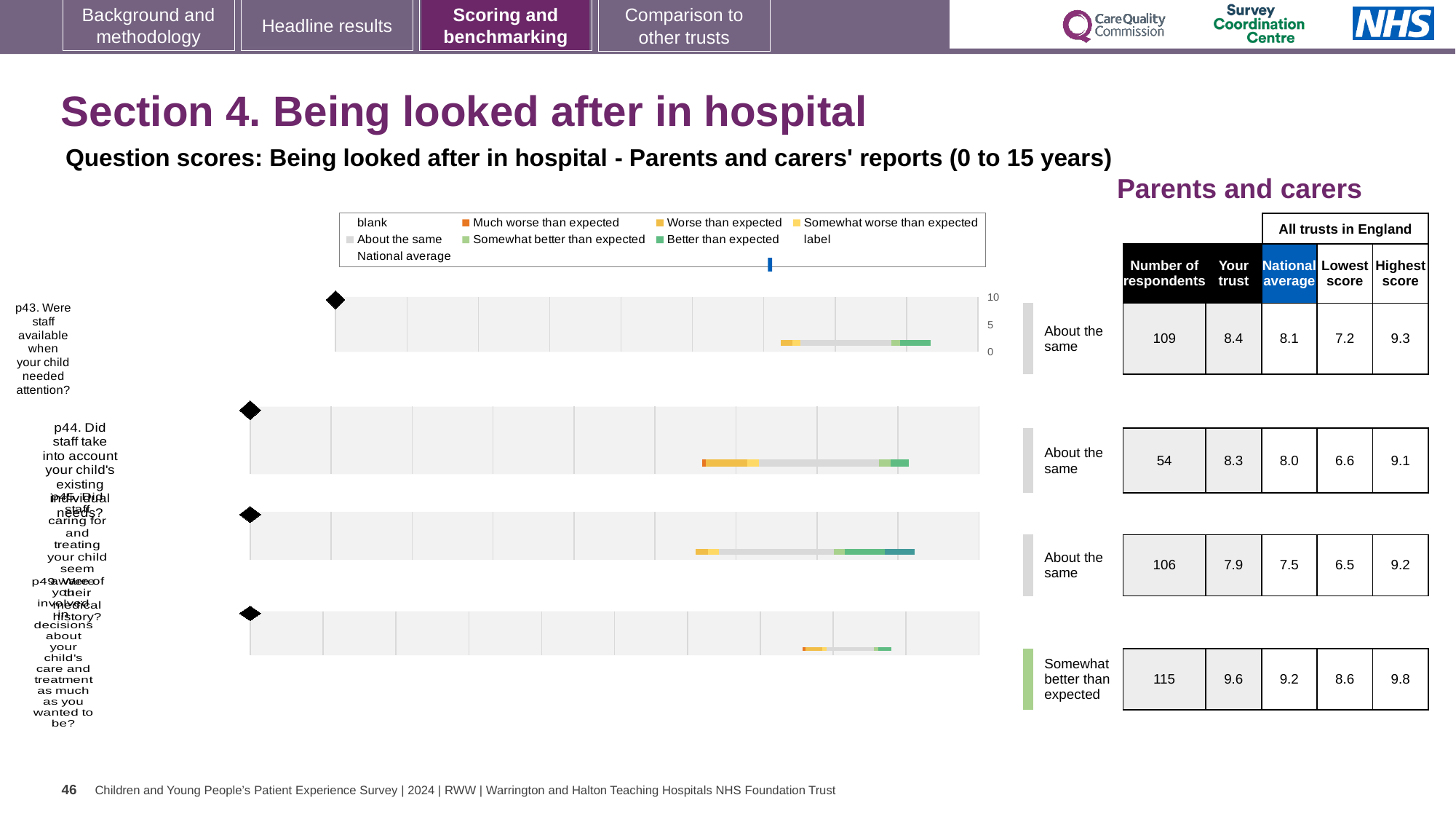
Which question has the highest 'Your trust' score? p49 What is the highest score across all trusts in England for p43? 9.3 Which question has the fewest respondents? p44 What kind of chart is used to show the question scores? bar chart Which question is rated 'Somewhat better than expected'? p49 What is the national average score for p44 (Did staff take into account your child's existing individual needs?)? 8.0 What is the lowest score across all trusts in England for p45? 6.5 What is the difference between the 'Your trust' score and the national average for p49? 0.4 How many respondents answered p49 (Were you involved in decisions about your child's care and treatment as much as you wanted to be?)? 115 Is the 'Your trust' score for p45 higher or lower than the national average? higher What is the 'Your trust' score for p43 (Were staff available when your child needed attention?)? 8.4 How many questions are plotted on the chart? 4